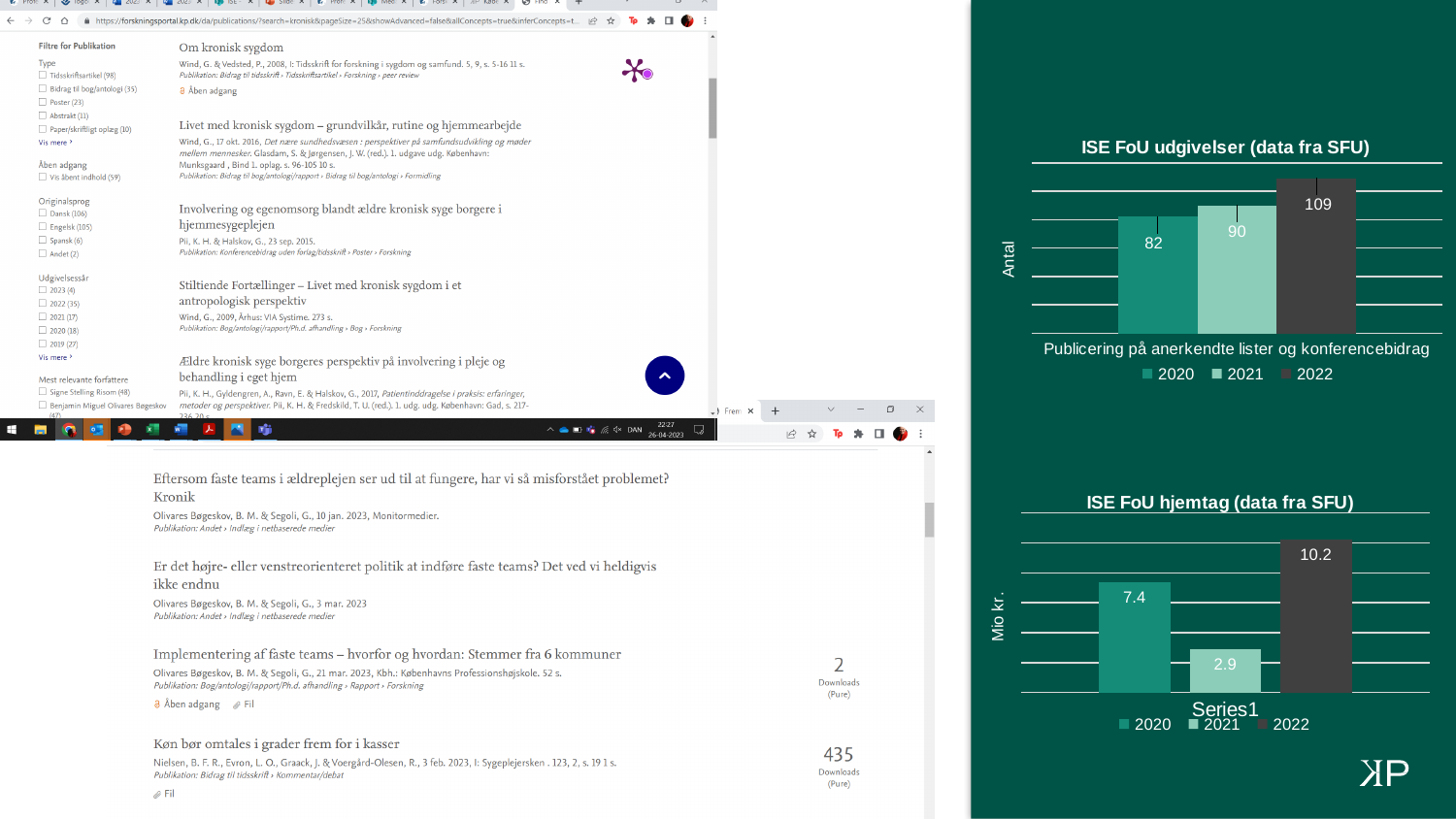
In the chart titled "ISE FoU udgivelser (data fra SFU)", what is the difference between the values for 2022 and 2021? 19 In the chart titled "ISE FoU udgivelser (data fra SFU)", what is the label on the vertical axis? Antal In the chart titled "ISE FoU udgivelser (data fra SFU)", do the values rise or fall from 2020 to 2022? rise In the chart titled "ISE FoU hjemtag (data fra SFU)", which year has the lowest value? 2021 In the chart titled "ISE FoU udgivelser (data fra SFU)", which year has the highest value? 2022 In the chart titled "ISE FoU hjemtag (data fra SFU)", what is the value for 2022? 10.2 What kind of chart is the chart titled "ISE FoU hjemtag (data fra SFU)"? bar chart In the chart titled "ISE FoU udgivelser (data fra SFU)", what is the value for 2020? 82 In the chart titled "ISE FoU hjemtag (data fra SFU)", how many series does the legend list? 3 In the chart titled "ISE FoU hjemtag (data fra SFU)", what is the value for 2021? 2.9 In the chart titled "ISE FoU hjemtag (data fra SFU)", is the value for 2020 or 2022 larger? 2022 In the chart titled "ISE FoU udgivelser (data fra SFU)", what is the value for 2022? 109